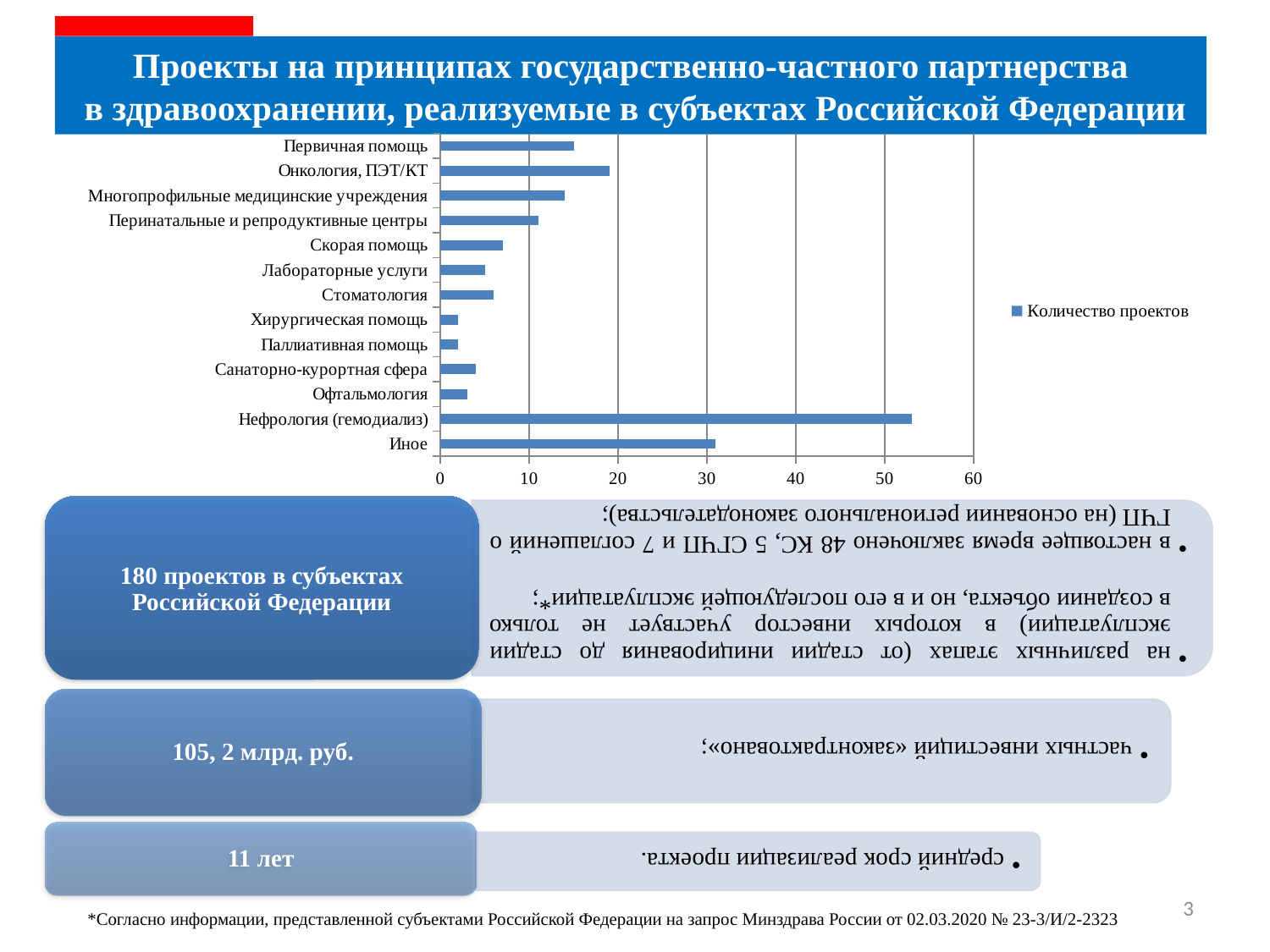
Which category has the highest value in the chart? Нефрология (гемодиализ) How many categories are plotted in the chart? 13 What kind of chart is shown on the slide? bar chart Is the value for Скорая помощь greater or less than 10? less Is the value for Иное greater or less than 20? greater Is the value for Нефрология (гемодиализ) greater or less than 50? greater Which has a larger value: Онкология, ПЭТ/КТ or Первичная помощь? Онкология, ПЭТ/КТ Which has a larger value: Нефрология (гемодиализ) or Иное? Нефрология (гемодиализ) How many series does the chart legend list? 1 What is the maximum value shown on the horizontal axis of the chart? 60 What is the name of the series shown in the chart legend? Количество проектов